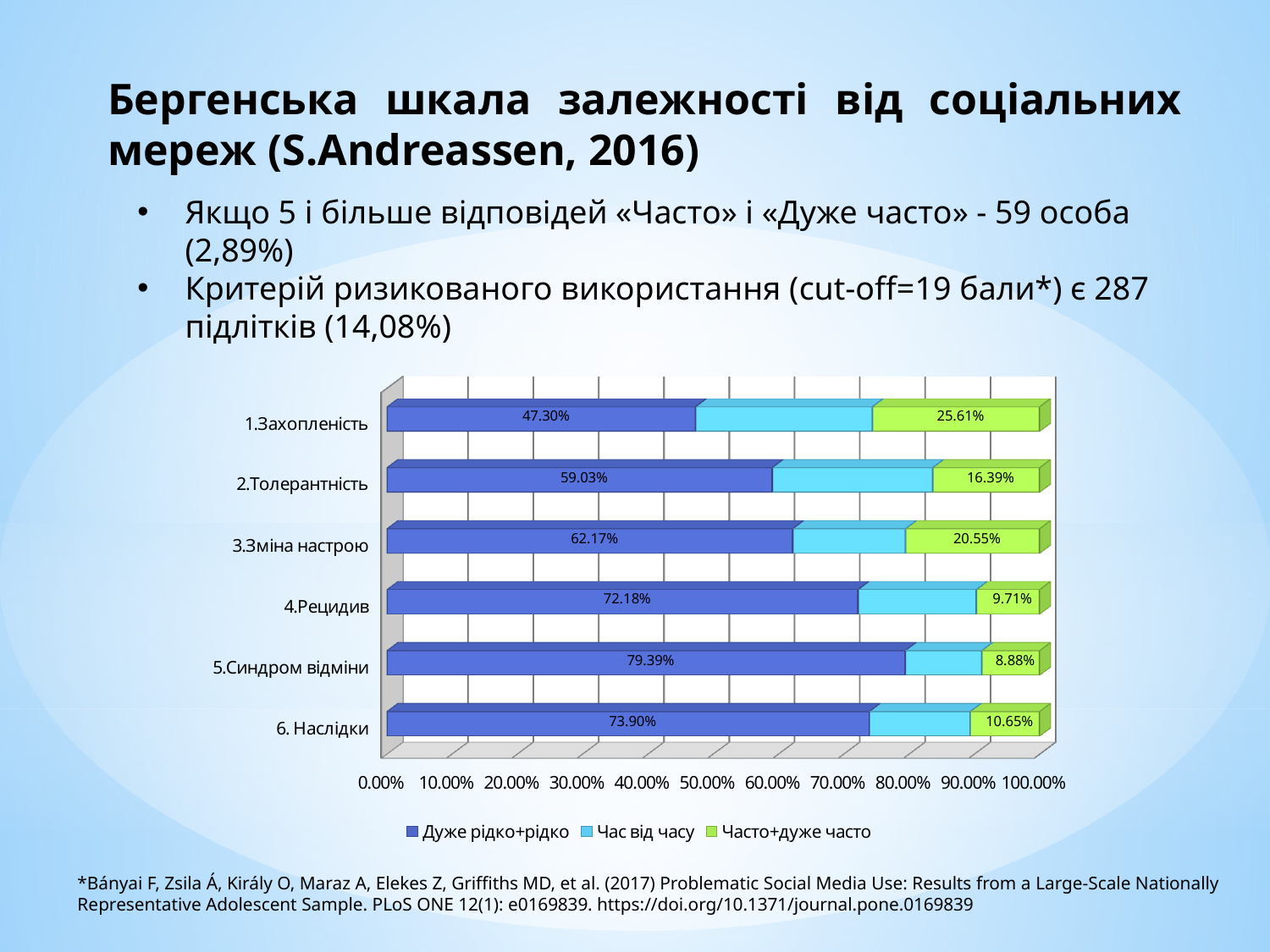
How many series does the legend list? 3 Which category has the lowest value for "Часто+дуже часто"? 5.Синдром відміни Which is larger: the "Часто+дуже часто" value for "1.Захопленість" or for "2.Толерантність"? 1.Захопленість Which category has the highest value for "Дуже рідко+рідко"? 5.Синдром відміни What is the value of "Часто+дуже часто" for "3.Зміна настрою"? 20.55% What is the name of the third series in the legend? Часто+дуже часто What is the value of "Часто+дуже часто" for "6. Наслідки"? 10.65% What is the value of "Дуже рідко+рідко" for "5.Синдром відміни"? 79.39% What type of chart is shown on the slide? stacked bar chart What is the difference between the "Дуже рідко+рідко" values for "4.Рецидив" and "2.Толерантність"? 13.15% How many categories are shown on the chart? 6 What is the value of "Дуже рідко+рідко" for "1.Захопленість"? 47.30%